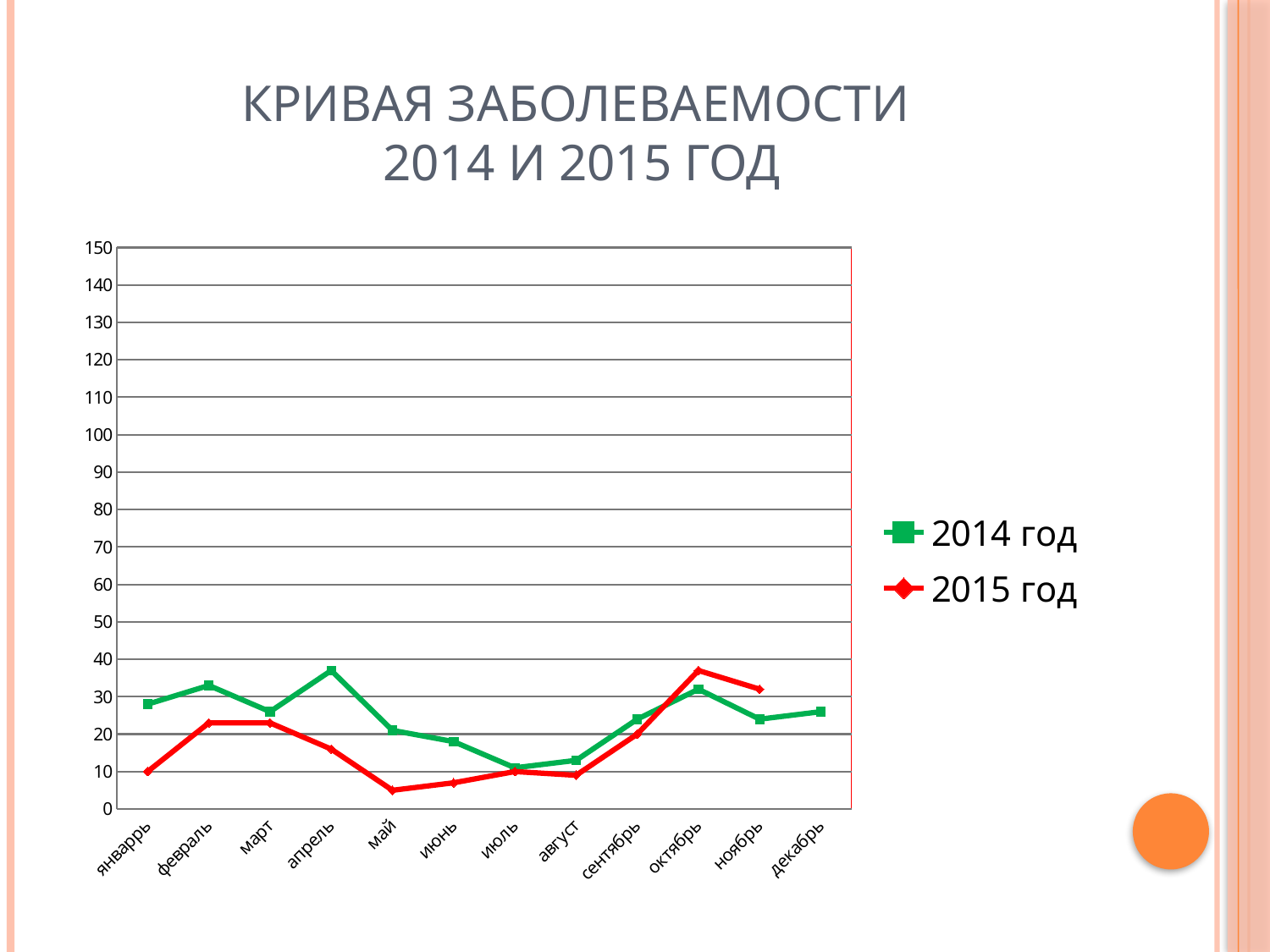
How many series does the legend list? 2 Is the value for 2015 год in май greater or less than 10? less What is the title of the chart? КРИВАЯ ЗАБОЛЕВАЕМОСТИ 2014 И 2015 ГОД In which month does the 2015 год series reach its lowest value? май In which month does the 2015 год series reach its highest value? октябрь What kind of chart is shown on the slide? line chart Which series has the larger value in апрель, 2014 год or 2015 год? 2014 год How many months are shown on the x axis? 12 Which colour is used for the 2015 год series? red In which month does the 2014 год series reach its highest value? апрель Is the value for 2014 год in апрель greater or less than 30? greater Does the 2015 год series rise or fall from май to октябрь? rise